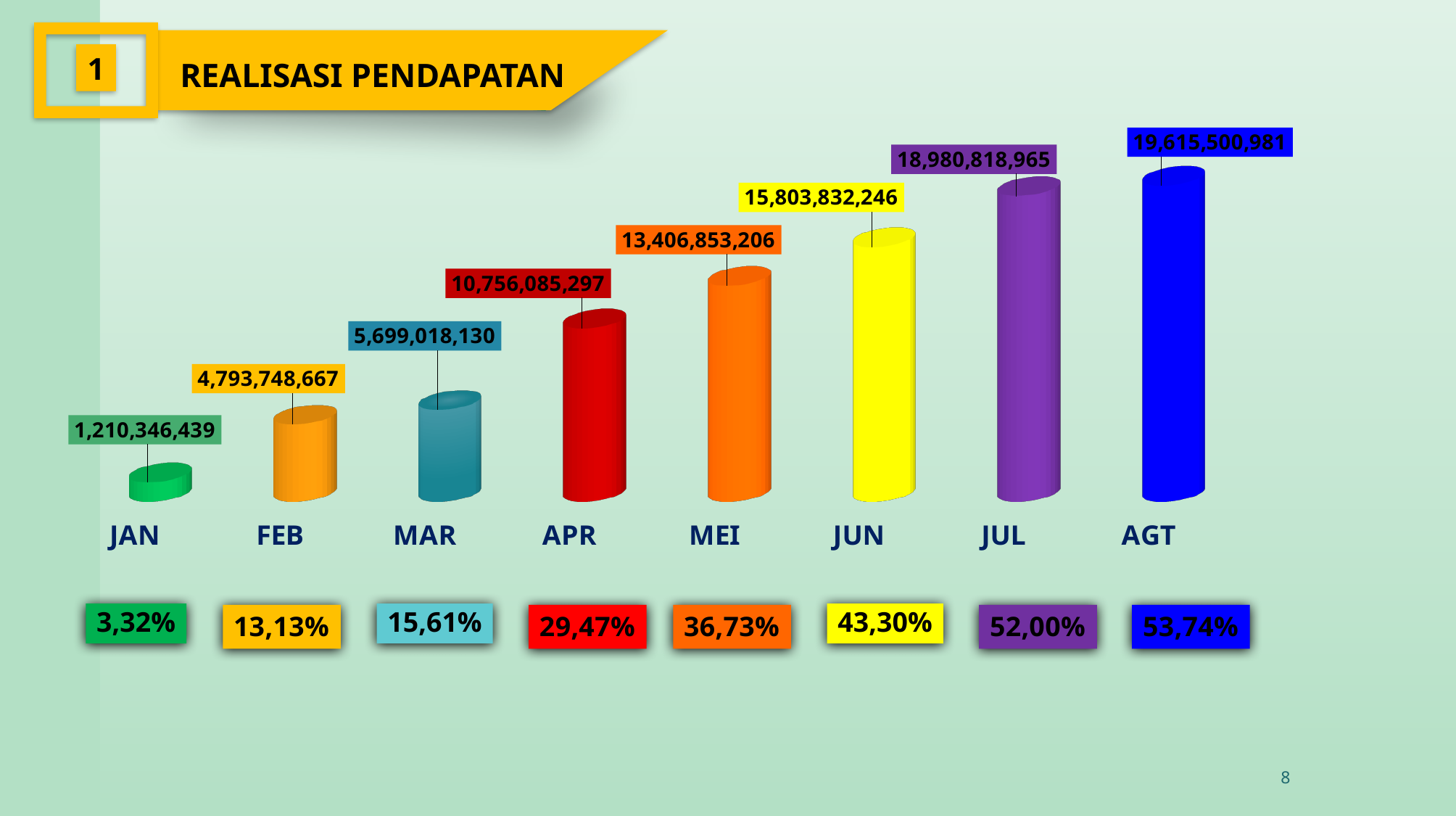
Which month has the lowest value? JAN What is the difference between the values for FEB and JAN? 3,583,402,228 Do the values rise or fall from JAN to AGT? Rise How many months are shown on the chart? 8 What kind of chart is shown on the slide? Bar chart Which is larger, the value for MAR or the value for MEI? MEI What is the value for JAN? 1,210,346,439 What is the value for APR? 10,756,085,297 Which month has the highest value? AGT What is the title of the chart? REALISASI PENDAPATAN What is the difference between the values for AGT and JUL? 634,682,016 What percentage is shown below the MEI bar? 36,73%